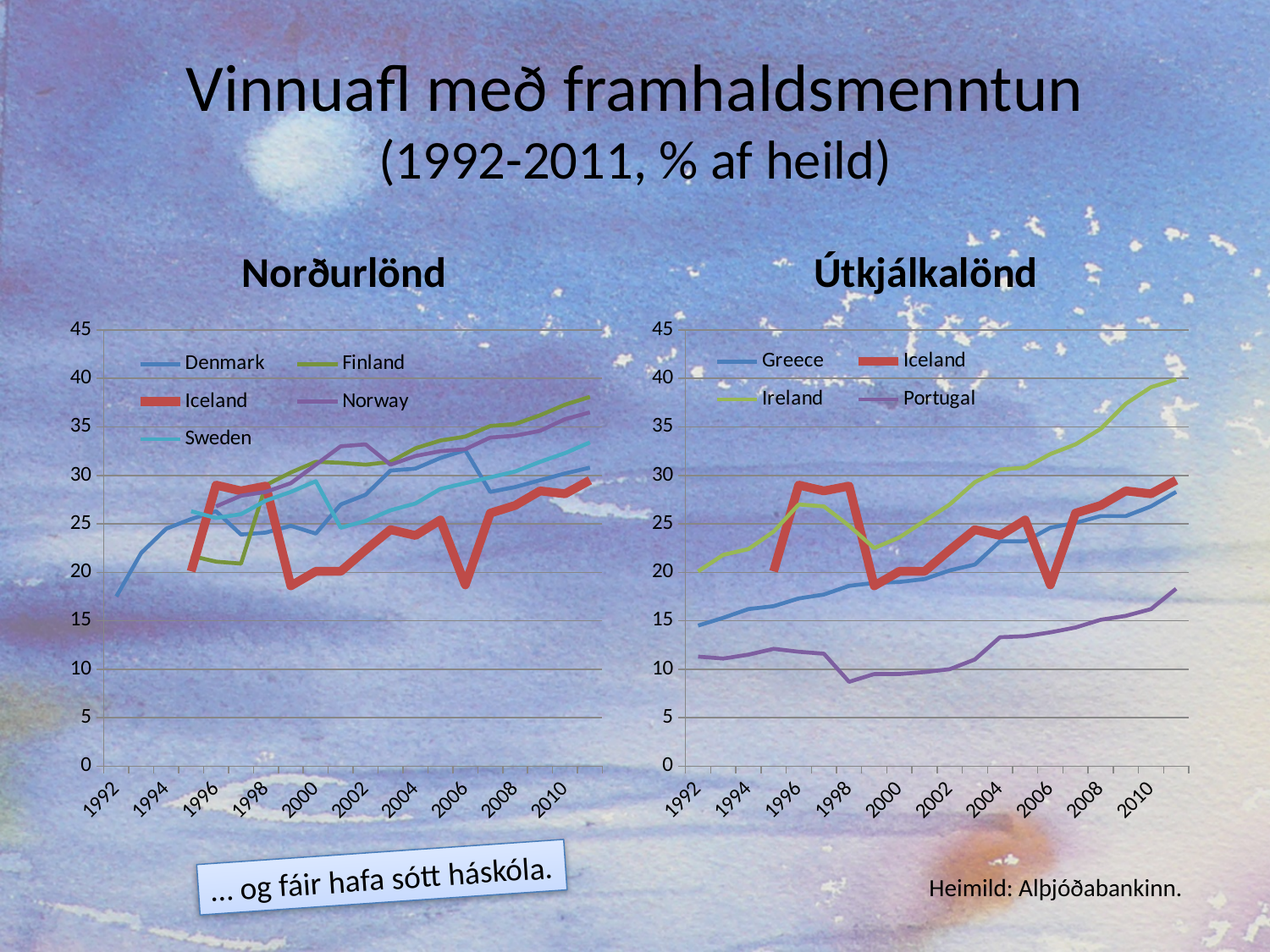
In the Útkjálkalönd chart, which series is highest in 2010? Ireland What is the title of the chart on the right? Útkjálkalönd In the Útkjálkalönd chart, is the value for Portugal in 1998 greater or less than 10? less In the Norðurlönd chart, which series is highest at the end of the period (2011)? Finland What kind of chart is the Norðurlönd chart on the left? line chart In the Útkjálkalönd chart, which series has the lowest values across the whole period? Portugal In the Útkjálkalönd chart, does the Greece series generally rise or fall from 1992 to 2011? rise In the Norðurlönd chart, is the value for Denmark in 1992 greater or less than 20? less In the Útkjálkalönd chart, which is larger in 2010, Ireland or Greece? Ireland How many series does the legend of the Útkjálkalönd chart list? 4 How many series does the legend of the Norðurlönd chart list? 5 In the Útkjálkalönd chart, is the value for Ireland in 2010 greater or less than 35? greater